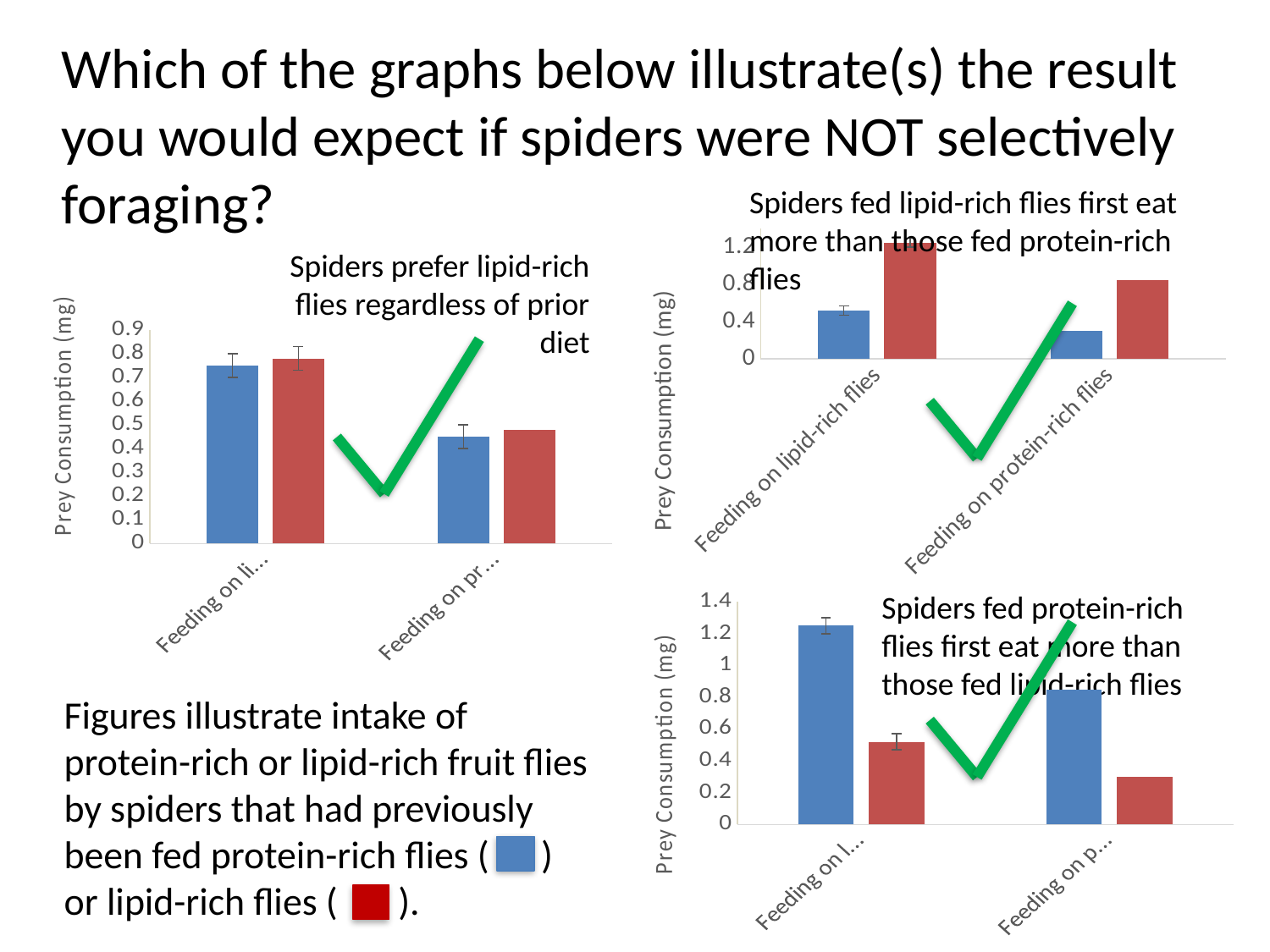
What kind of chart is the chart titled "Spiders prefer lipid-rich flies regardless of prior diet"? bar chart In the chart titled "Spiders fed protein-rich flies first eat more than those fed lipid-rich flies", which bar is taller for the first category, the blue bar or the red bar? the blue bar In the chart titled "Spiders fed lipid-rich flies first eat more than those fed protein-rich flies", is the red bar for "Feeding on lipid-rich flies" greater or less than 0.8? greater What is the y-axis label on the chart titled "Spiders fed protein-rich flies first eat more than those fed lipid-rich flies"? Prey Consumption (mg) How many charts are shown on the slide? 3 In the chart titled "Spiders fed lipid-rich flies first eat more than those fed protein-rich flies", is the blue bar for "Feeding on protein-rich flies" greater or less than 0.4? less According to the slide text, which colour of bar represents spiders that had previously been fed protein-rich flies? blue In the chart titled "Spiders fed lipid-rich flies first eat more than those fed protein-rich flies", which bar is taller for "Feeding on lipid-rich flies", the blue bar or the red bar? the red bar In the chart titled "Spiders prefer lipid-rich flies regardless of prior diet", is the blue bar for the first category greater or less than 0.6? greater In the chart titled "Spiders fed lipid-rich flies first eat more than those fed protein-rich flies", how many categories are on the x axis? 2 In the chart titled "Spiders prefer lipid-rich flies regardless of prior diet", do the blue bars rise or fall from the first category to the second? fall